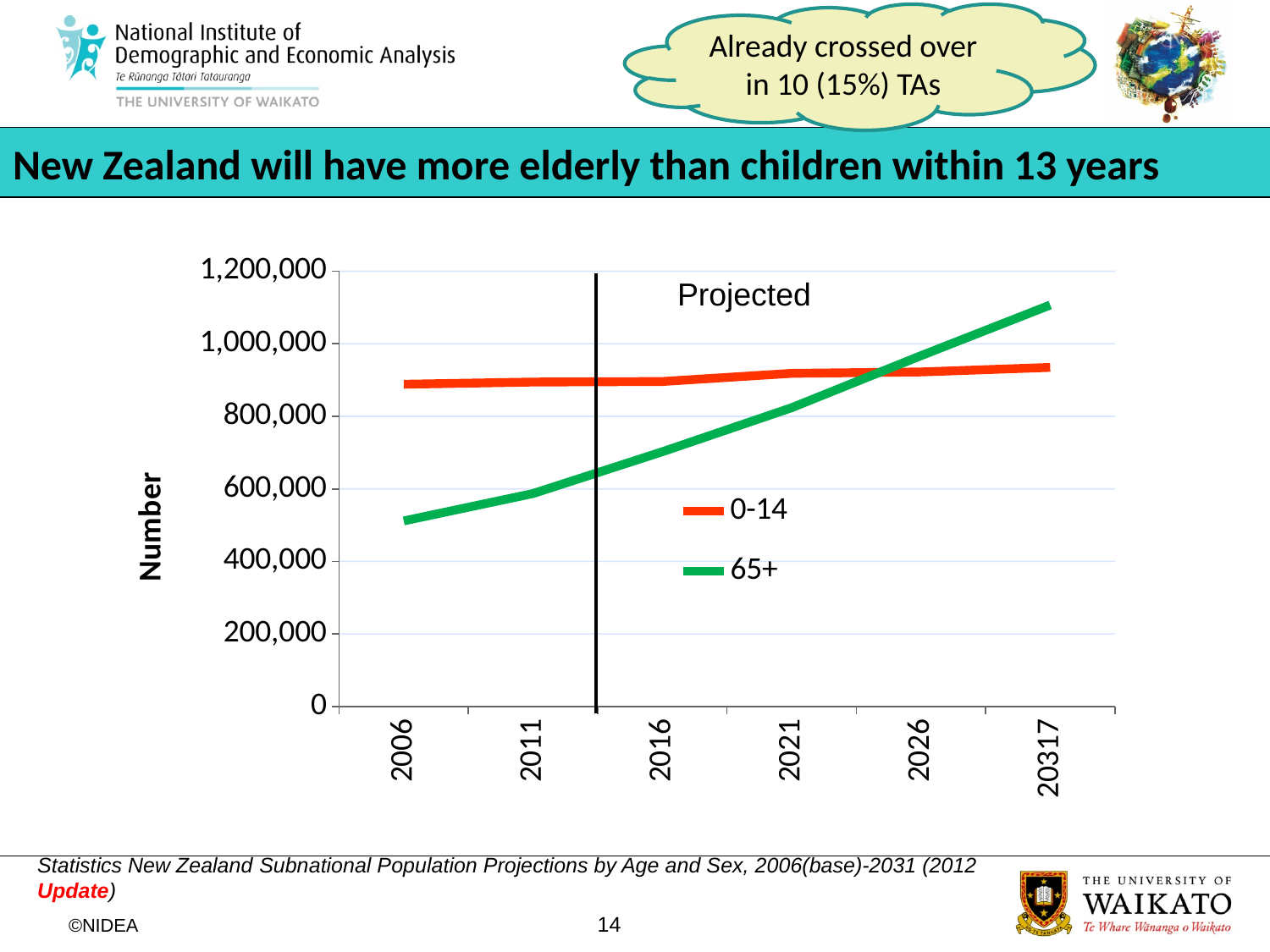
Is the value for 65+ in 2006 greater or less than 600,000? less At the last year on the x axis, which series has the larger value, 0-14 or 65+? 65+ Does the 65+ line rise or fall from 2006 to the end of the chart? rises Is the value for 0-14 in 2006 greater or less than 800,000? greater Is the value for 65+ at the last year on the x axis greater or less than 1,000,000? greater What are the two series named in the chart legend? 0-14 and 65+ In 2006, which series has the larger value, 0-14 or 65+? 0-14 How many year labels are shown along the x axis of the chart? 6 How many series does the chart legend list? 2 What kind of chart is shown on the slide? line chart What is the label on the vertical axis of the chart? Number